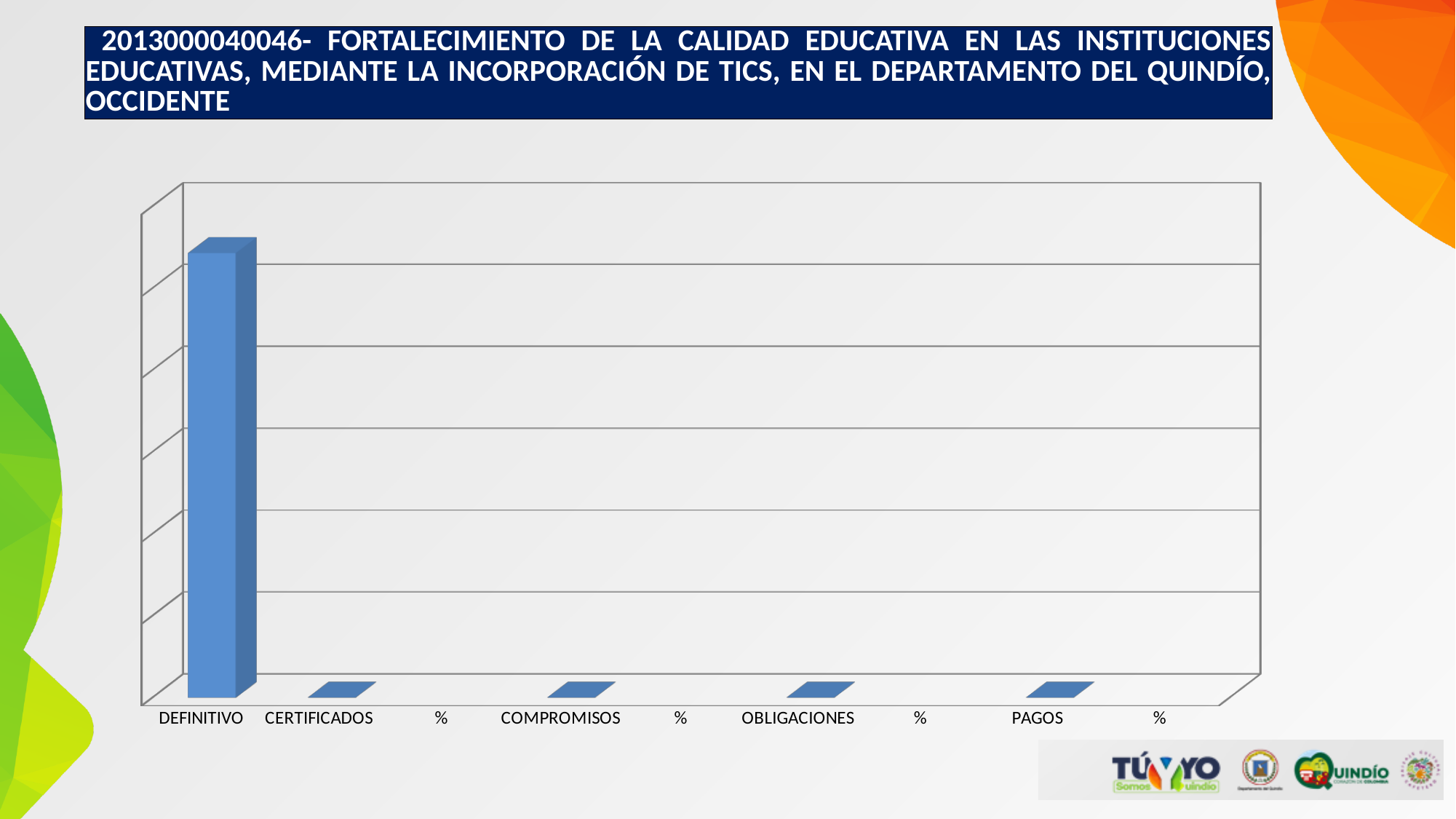
Which is larger, the bar for DEFINITIVO or the bar for PAGOS? DEFINITIVO What kind of chart is shown on the slide? bar chart How many categories are shown on the x axis of the chart? 9 What is the label of the first category on the x axis? DEFINITIVO Which is larger, the bar for DEFINITIVO or the bar for OBLIGACIONES? DEFINITIVO What is the label of the last category on the x axis? % Which is larger, the bar for DEFINITIVO or the bar for CERTIFICADOS? DEFINITIVO Which category has the highest bar in the chart? DEFINITIVO